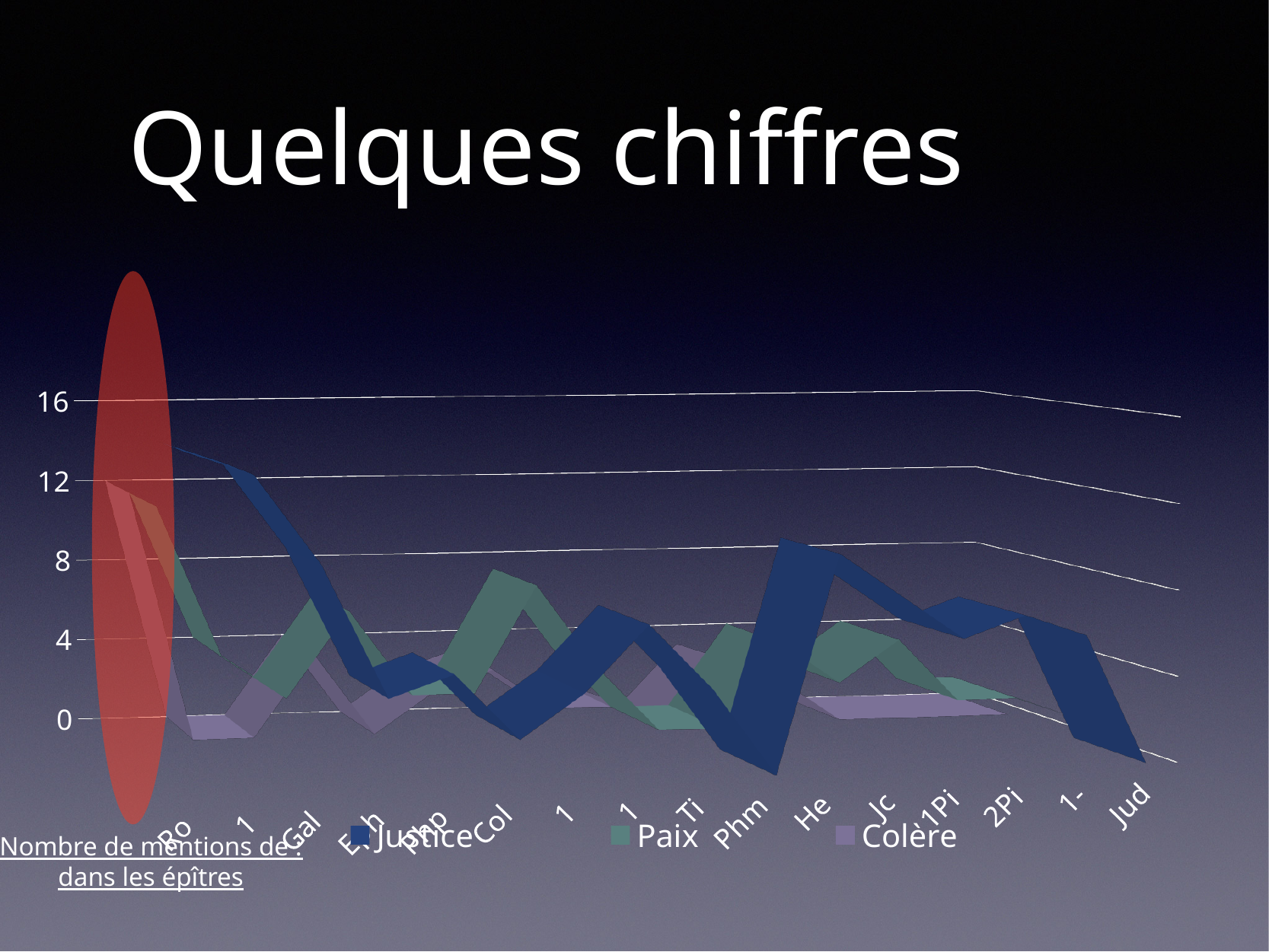
How many series does the legend list? 3 What are the three series named in the legend? Justice, Paix, Colère Is the value of Paix for Col greater or less than 4? less Is the value of Justice for He greater or less than 4? greater Is the value of Justice for Ro greater or less than 12? greater What is the highest value shown on the vertical axis? 16 Does the Justice series rise or fall from Ro to Gal? fall What kind of chart is shown on the slide? line chart What is the title of the slide? Quelques chiffres Which series has the highest value at He? Justice